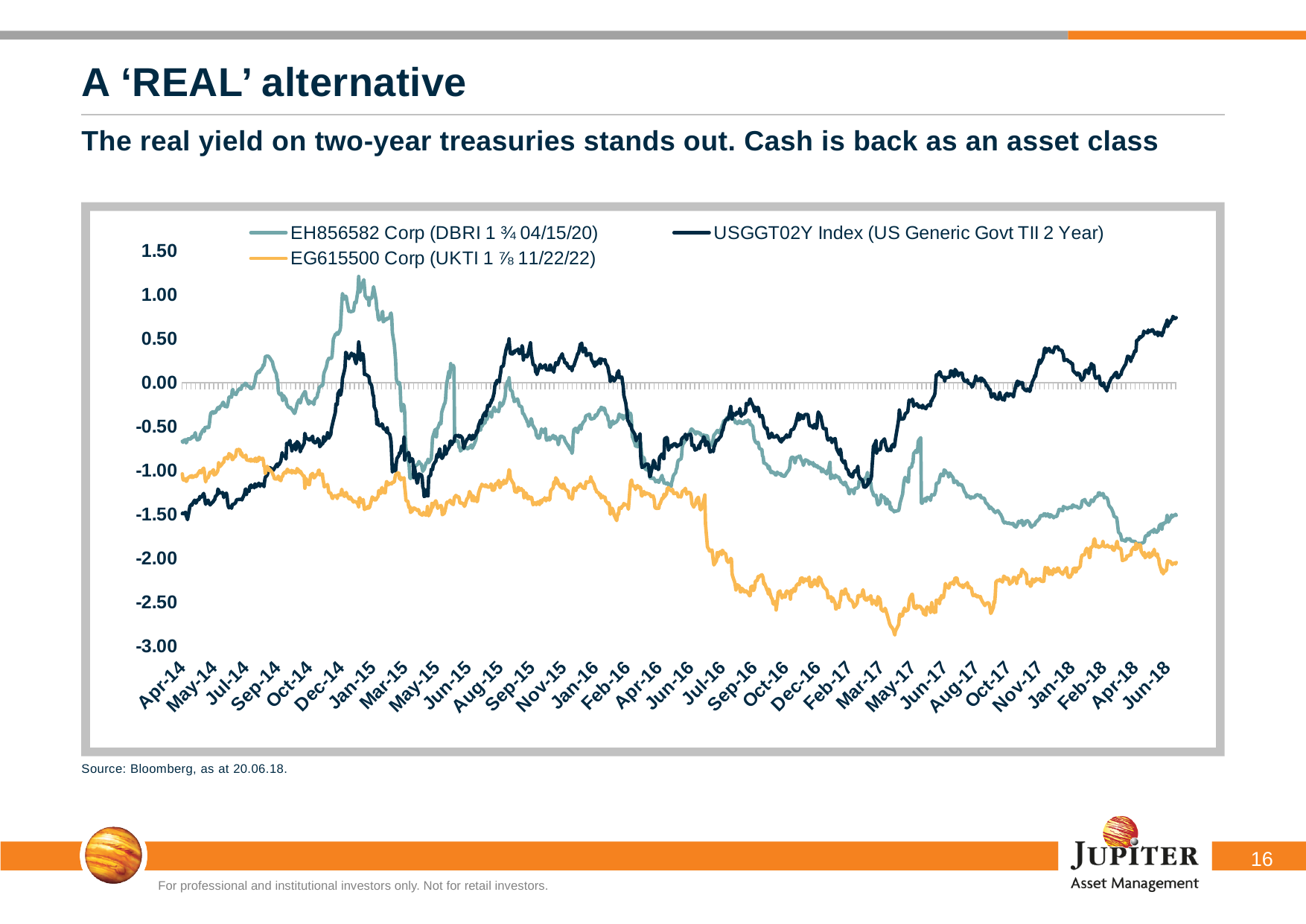
Which series is plotted with the dark navy line? USGGT02Y Index (US Generic Govt TII 2 Year) Is the lowest value of EG615500 Corp around Mar-17 greater or less than -2.50? less Is the value of the USGGT02Y Index at Jun-18 greater or less than 0.50? greater Does the USGGT02Y Index line rise or fall between Mar-17 and Jun-18? Rise Which series has the lowest value at Jun-18, the right end of the chart? EG615500 Corp (UKTI 1 ⅞ 11/22/22) How many series does the chart's legend list? 3 At Jan-15, which series is higher: EH856582 Corp or USGGT02Y Index? EH856582 Corp Is the peak value of EH856582 Corp around Jan-15 greater or less than 1.00? greater Which series has the highest value at Jun-18, the right end of the chart? USGGT02Y Index (US Generic Govt TII 2 Year) What kind of chart is shown on the slide? Line chart What is the source cited beneath the chart? Bloomberg, as at 20.06.18